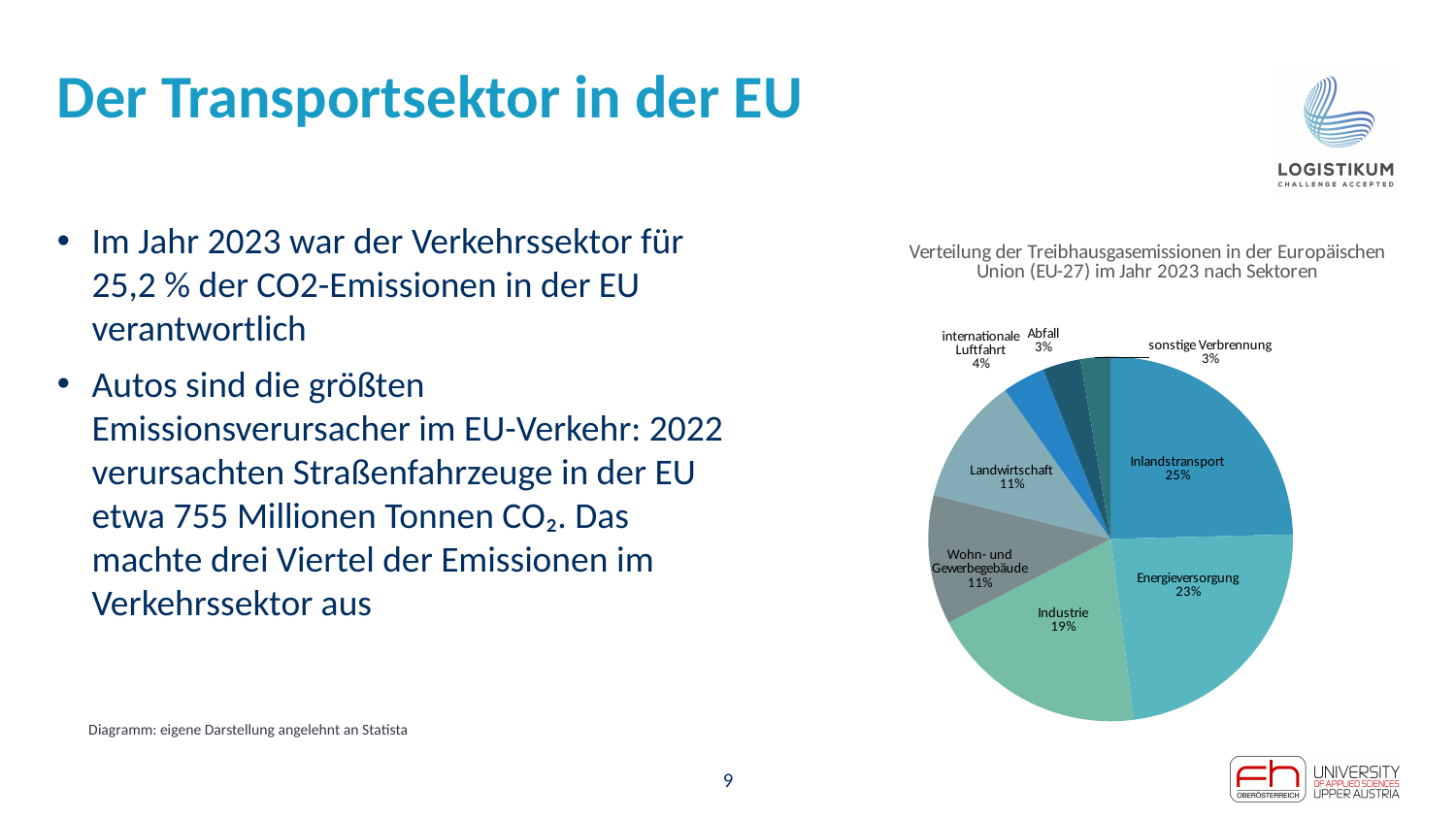
What share of the pie does Inlandstransport have? 25% Which sector has the largest slice of the pie? Inlandstransport What is the value shown for internationale Luftfahrt? 4% What is the difference in percentage points between Inlandstransport and Energieversorgung? 2 Which is larger, the share for Industrie or the share for Wohn- und Gewerbegebäude? Industrie What is the value shown for Industrie? 19% What share of the pie does Energieversorgung have? 23% How many sectors are shown in the pie chart? 8 What is the value shown for Abfall? 3% What is the title of the chart? Verteilung der Treibhausgasemissionen in der Europäischen Union (EU-27) im Jahr 2023 nach Sektoren What is the value shown for Landwirtschaft? 11% What kind of chart is shown on the slide? pie chart